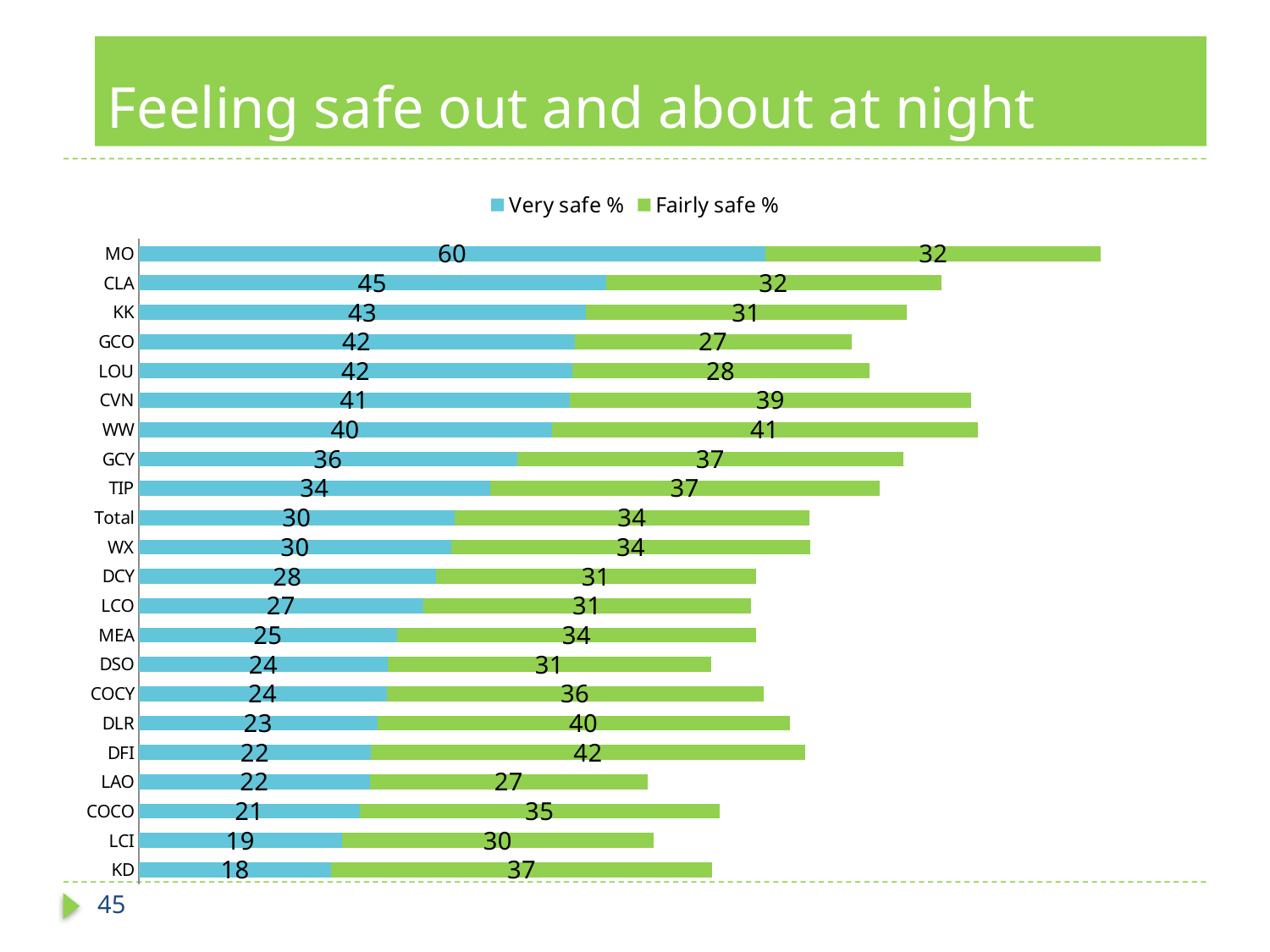
Which category has the lowest Very safe % value? KD What is the Very safe % value for MO? 60 What kind of chart is shown on the slide? Stacked bar chart What is the total of the stacked bar for MO? 92 Which category has the highest Very safe % value? MO What is the total of the stacked bar for KD? 55 What is the Fairly safe % value for DFI? 42 Which has the larger Fairly safe % value, WW or CVN? WW What is the title of the slide? Feeling safe out and about at night How many categories are shown on the chart? 22 What is the difference between the Very safe % values for MO and CLA? 15 How many series does the legend list? 2